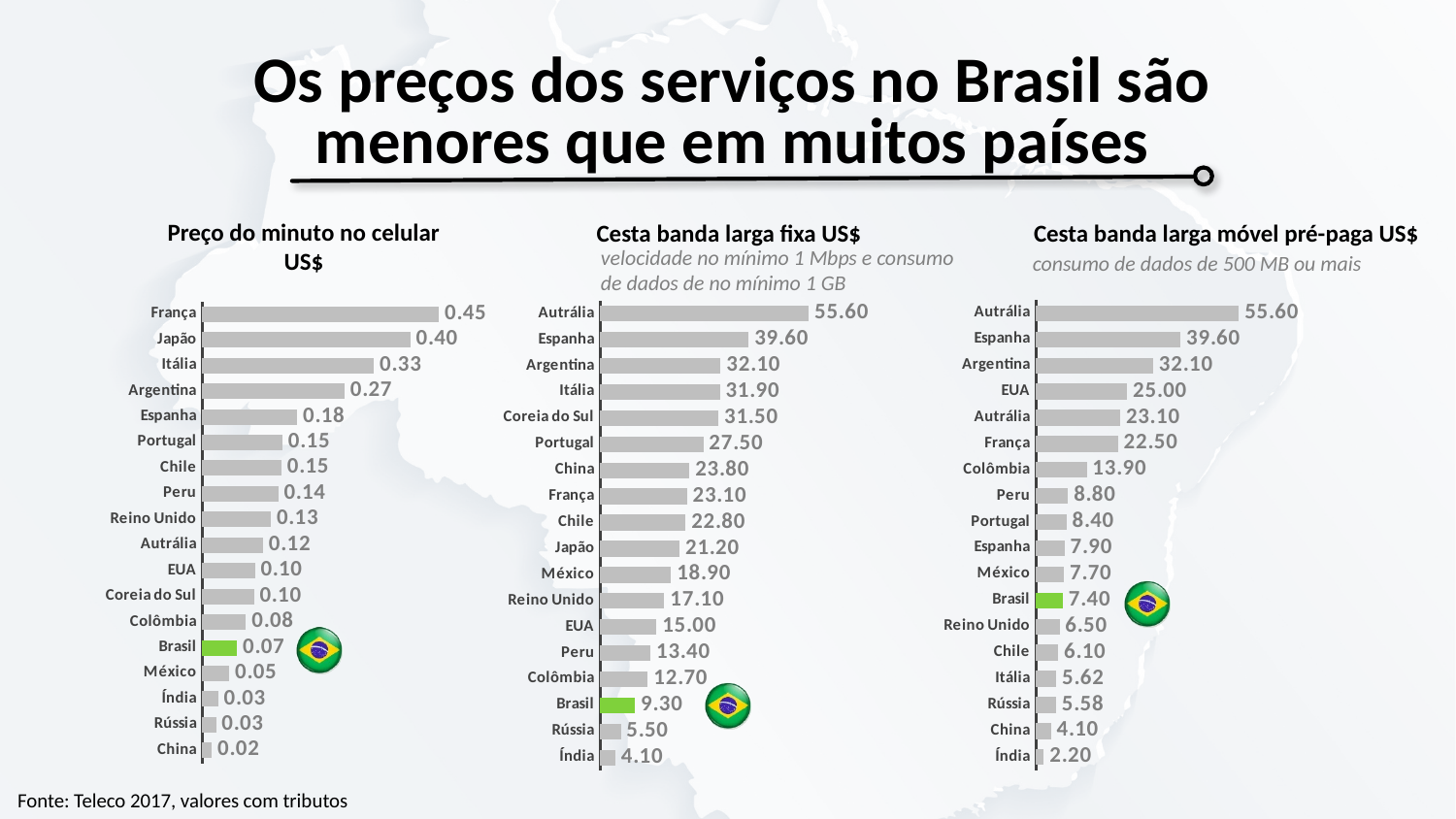
In the 'Cesta banda larga móvel pré-paga US$' chart, what is the value for EUA? 25.00 In the 'Cesta banda larga fixa US$' chart, what is the difference between Espanha and Argentina? 7.50 In the 'Preço do minuto no celular US$' chart, what is the value for Brasil? 0.07 In the 'Cesta banda larga móvel pré-paga US$' chart, what is the value for Brasil? 7.40 In the 'Preço do minuto no celular US$' chart, what is the difference between França and Japão? 0.05 How many countries are listed in the 'Cesta banda larga móvel pré-paga US$' chart? 18 In the 'Cesta banda larga fixa US$' chart, what is the value for Brasil? 9.30 In the 'Preço do minuto no celular US$' chart, which country has the highest value? França In the 'Cesta banda larga fixa US$' chart, which country has the lowest value? Índia What type of chart is the 'Preço do minuto no celular US$' chart? Bar chart In the 'Cesta banda larga fixa US$' chart, which is larger, Portugal or China? Portugal In the 'Preço do minuto no celular US$' chart, which country has the lowest value? China